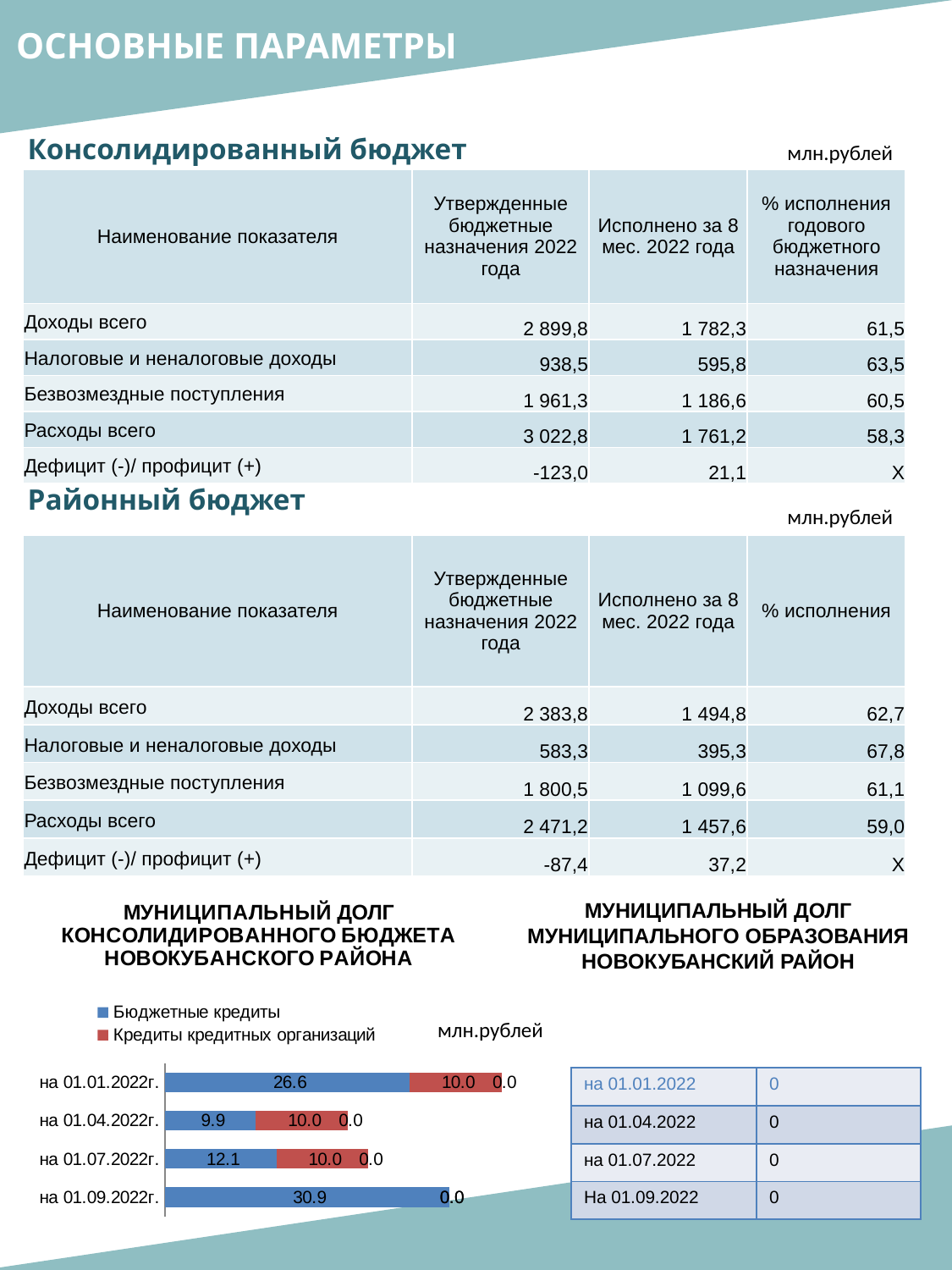
In the chart 'Муниципальный долг консолидированного бюджета Новокубанского района', what is the value of Бюджетные кредиты на 01.09.2022г.? 30.9 In the chart 'Муниципальный долг консолидированного бюджета Новокубанского района', on which date is the value of Бюджетные кредиты the highest? на 01.09.2022г. In the chart 'Муниципальный долг консолидированного бюджета Новокубанского района', what is the value of Кредиты кредитных организаций на 01.04.2022г.? 10.0 What kind of chart is 'Муниципальный долг консолидированного бюджета Новокубанского района'? Bar chart In the chart 'Муниципальный долг консолидированного бюджета Новокубанского района', what is the difference between Бюджетные кредиты на 01.09.2022г. and на 01.01.2022г.? 4.3 How many dates (categories) are shown in the chart 'Муниципальный долг консолидированного бюджета Новокубанского района'? 4 In the chart 'Муниципальный долг консолидированного бюджета Новокубанского района', on which date is the value of Бюджетные кредиты the lowest? на 01.04.2022г. In the chart 'Муниципальный долг консолидированного бюджета Новокубанского района', which is larger: Бюджетные кредиты на 01.07.2022г. or на 01.04.2022г.? на 01.07.2022г. How many series does the legend of the chart 'Муниципальный долг консолидированного бюджета Новокубанского района' list? 2 In the chart 'Муниципальный долг консолидированного бюджета Новокубанского района', by how much do Бюджетные кредиты на 01.07.2022г. exceed those на 01.04.2022г.? 2.2 In the chart 'Муниципальный долг консолидированного бюджета Новокубанского района', what is the value of Бюджетные кредиты на 01.01.2022г.? 26.6 In the chart 'Муниципальный долг консолидированного бюджета Новокубанского района', what is the total of Бюджетные кредиты and Кредиты кредитных организаций на 01.01.2022г.? 36.6